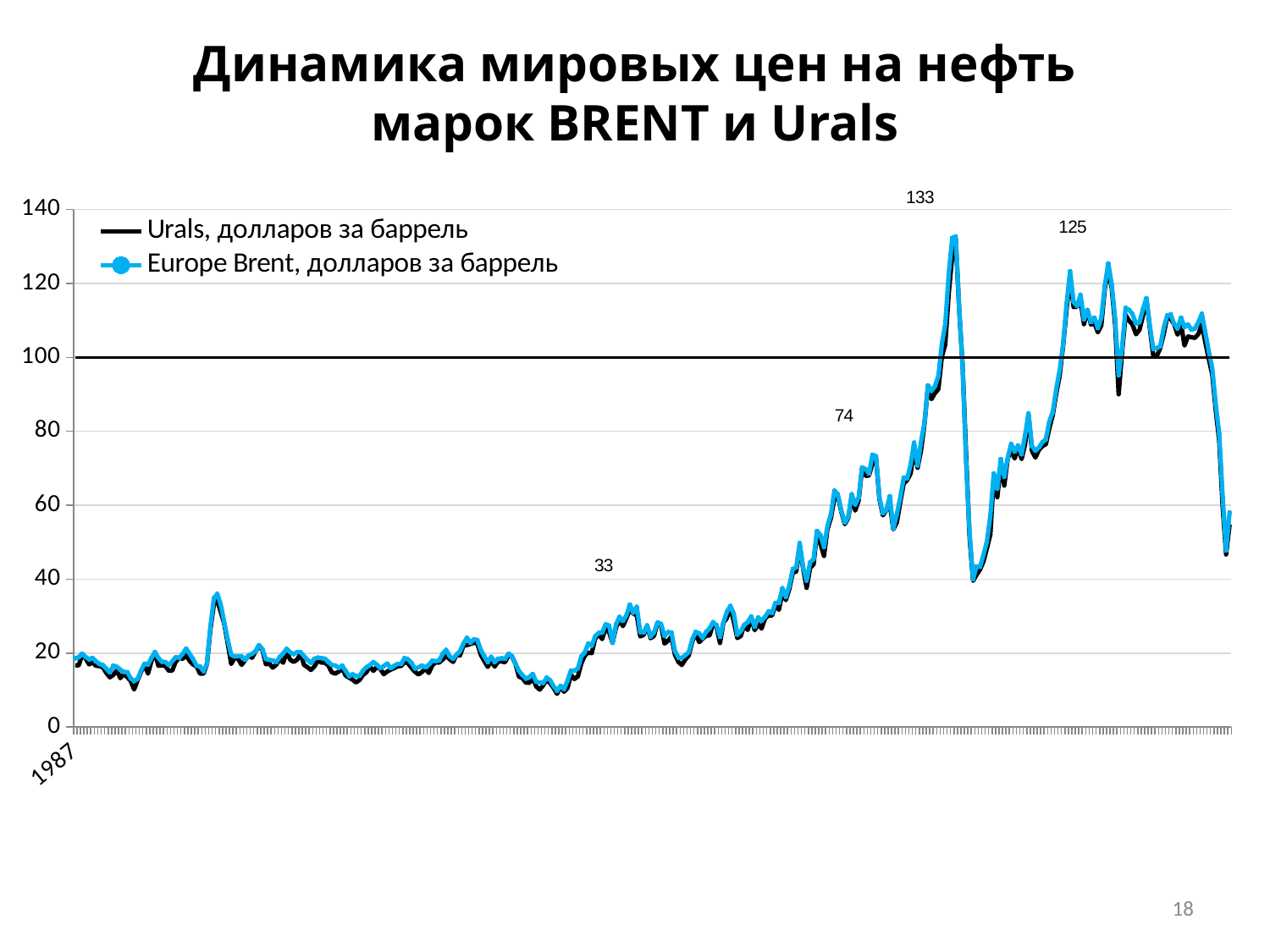
Is the highest peak of the Europe Brent line greater or less than 120? greater Overall, do the oil prices rise or fall from 1987 to the end of the series? rise How many data labels are printed on the chart? 4 What is the difference between the labeled peaks 133 and 125? 8 What are the two series named in the legend? Urals, долларов за баррель; Europe Brent, долларов за баррель What is the lowest value labeled on the chart? 33 Is the value of the Urals line at the start of the series in 1987 greater or less than 40? less How many series does the legend list? 2 What is the highest value labeled on the chart? 133 What kind of chart is shown on the slide? line chart What is the title of the chart on the slide? Динамика мировых цен на нефть марок BRENT и Urals What is the difference between the labeled values 74 and 33? 41